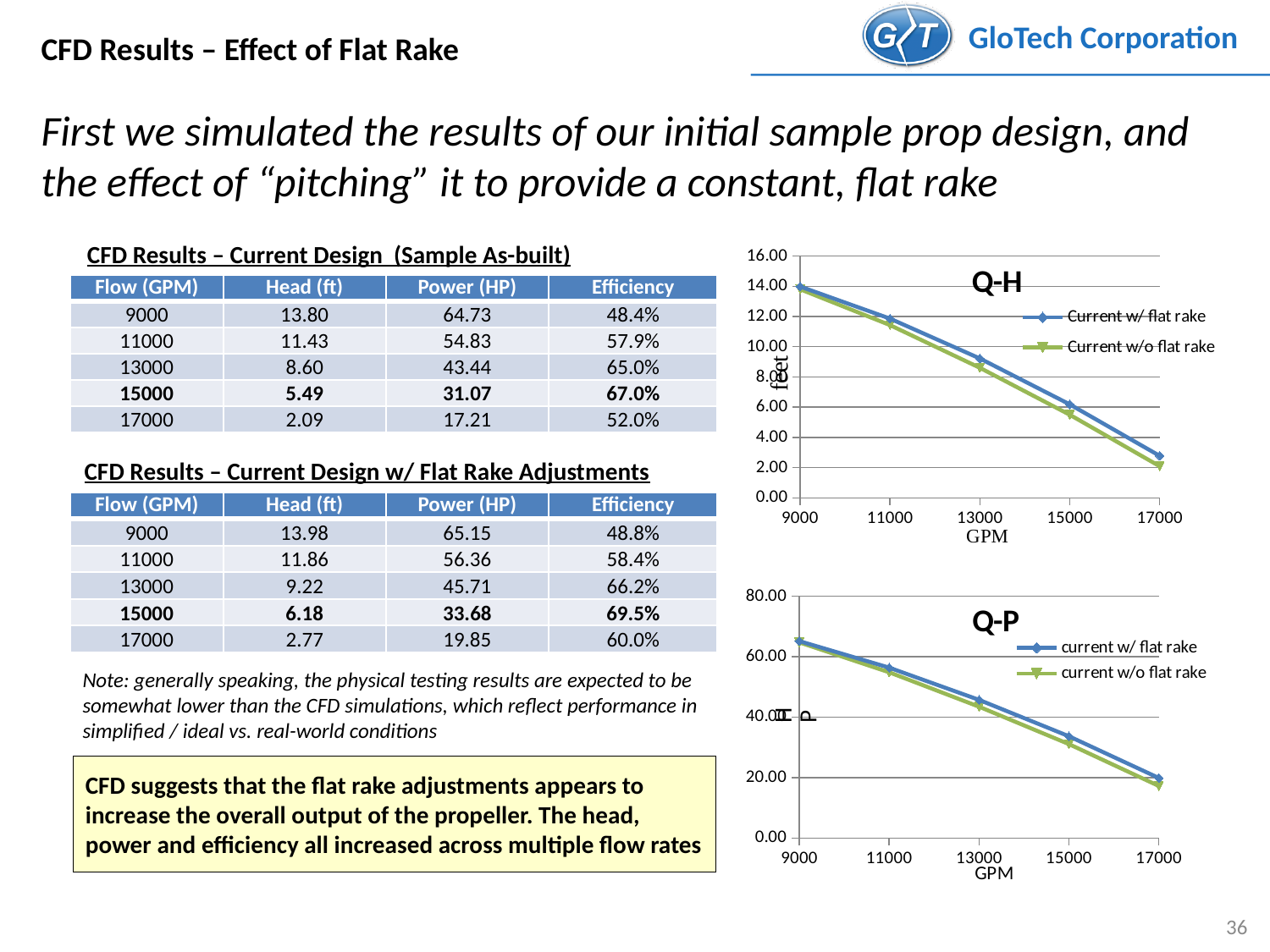
In the Q-H chart, which series has the higher value at 15000 GPM? Current w/ flat rake In the Q-H chart, is the value for Current w/ flat rake at 13000 GPM greater or less than 8.00? greater In the Q-P chart, is the value for current w/ flat rake at 9000 GPM greater or less than 60.00? greater In the Q-H chart, is the value for Current w/o flat rake at 11000 GPM greater or less than 10.00? greater How many series does the legend of the Q-P chart list? 2 In the Q-H chart, do the values rise or fall as GPM increases? fall How many series does the legend of the Q-H chart list? 2 In the Q-P chart, do the values rise or fall as GPM increases? fall What is the x-axis label of the Q-P chart? GPM What kind of chart is the Q-H chart? line chart How many data points does each series in the Q-H chart have? 5